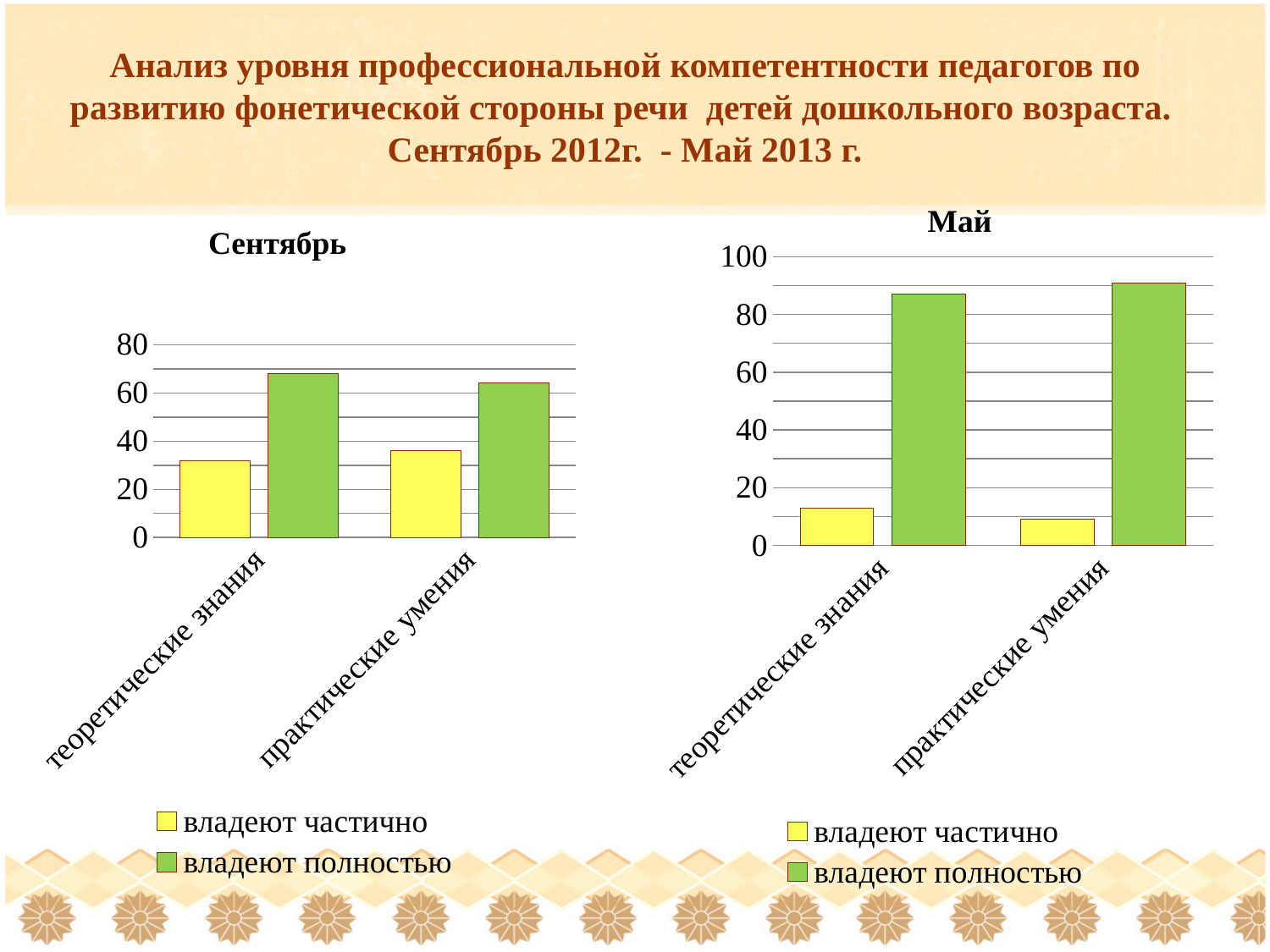
In the "Май" chart, is the value for "владеют частично" in "теоретические знания" greater or less than 20? less In the "Сентябрь" chart, which category has the higher value for "владеют частично"? практические умения In the "Май" chart, which category has the lower value for "владеют частично"? практические умения In the "Сентябрь" chart, is the value for "владеют частично" in "практические умения" greater or less than 40? less What kind of chart is the "Сентябрь" chart? bar chart How many categories are shown on the x axis of the "Сентябрь" chart? 2 In the "Май" chart, which series has the larger value for "теоретические знания": "владеют частично" or "владеют полностью"? владеют полностью What colour are the "владеют полностью" bars in the "Май" chart? green In the "Сентябрь" chart, is the value for "владеют полностью" in "теоретические знания" greater or less than 60? greater What is the title of the chart on the left side of the slide? Сентябрь How many series does the legend of the "Май" chart list? 2